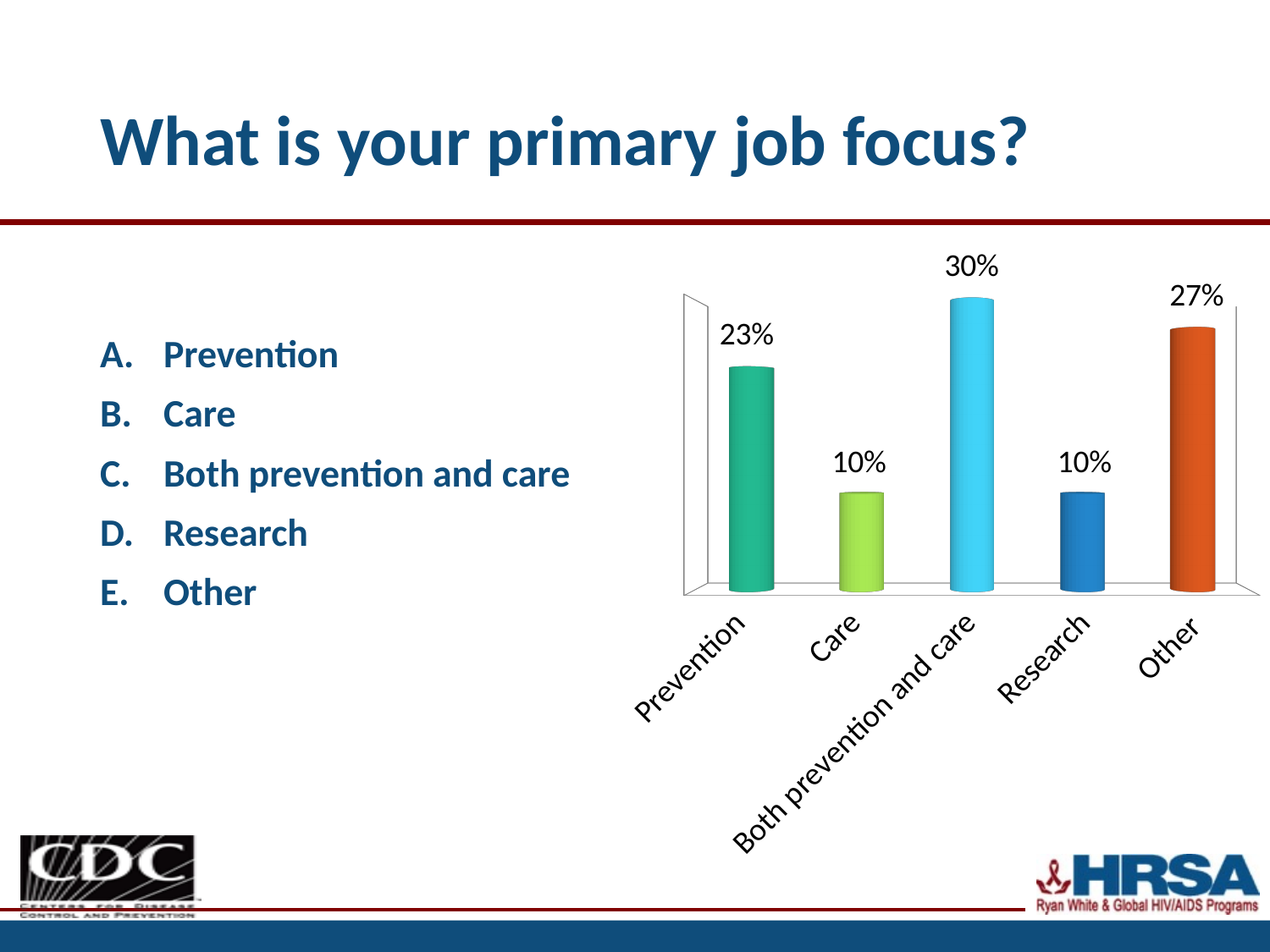
What kind of chart is shown on the slide? Bar chart What colour is the bar for Care? Green What is the difference between the values for Other and Care? 17% What is the value for Research? 10% Which is larger, the value for Prevention or the value for Other? Other What is the value for Both prevention and care? 30% Which is larger, the value for Care or the value for Prevention? Prevention What is the value for Prevention? 23% What is the difference between the values for Both prevention and care and Prevention? 7% Which category has the highest value? Both prevention and care How many categories are shown in the chart? 5 What is the value for Other? 27%